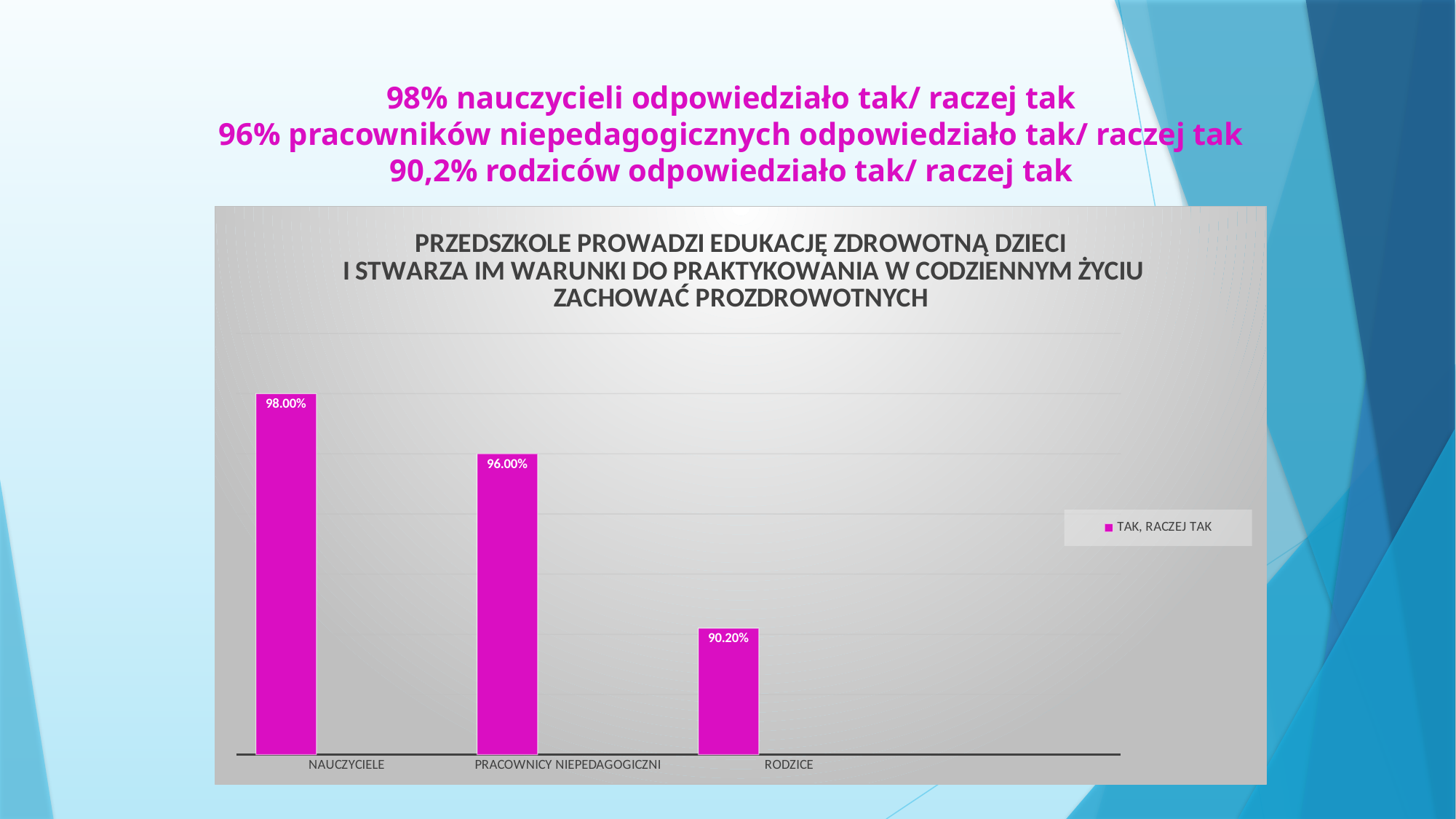
How many categories are shown on the x axis? 3 What is the legend entry for the series shown? TAK, RACZEJ TAK Which category has the lowest value? RODZICE What is the value for PRACOWNICY NIEPEDAGOGICZNI? 96.00% What kind of chart is shown on the slide? bar chart Which category has the highest value? NAUCZYCIELE What is the value for RODZICE? 90.20% Which is larger, the value for PRACOWNICY NIEPEDAGOGICZNI or the value for RODZICE? PRACOWNICY NIEPEDAGOGICZNI How many series does the legend list? 1 What is the value for NAUCZYCIELE? 98.00% What is the difference between the values for NAUCZYCIELE and RODZICE? 7.80% What is the difference between the values for NAUCZYCIELE and PRACOWNICY NIEPEDAGOGICZNI? 2.00%